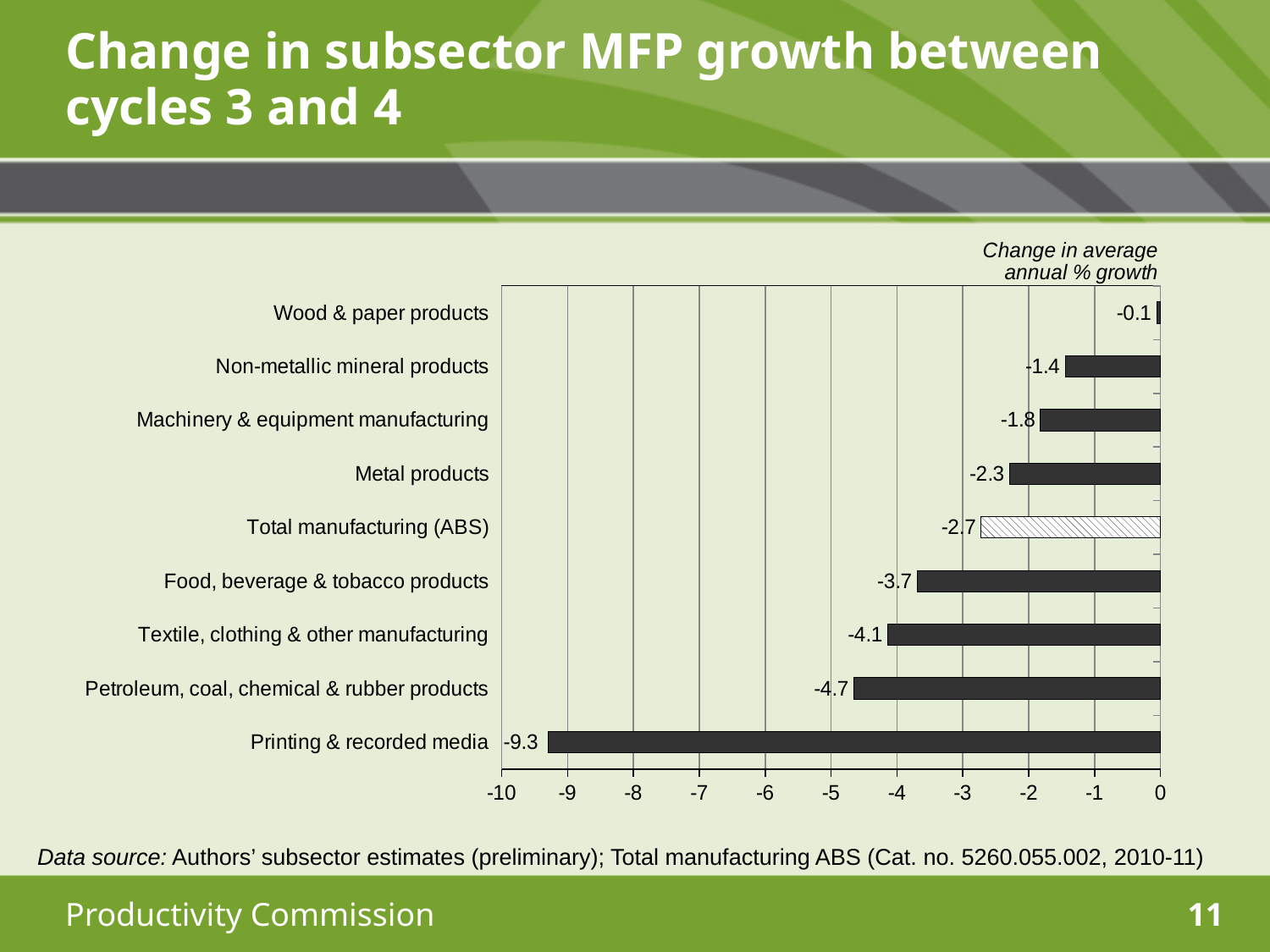
What is the value for Metal products? -2.3 What is the difference between the values for Food, beverage & tobacco products and Textile, clothing & other manufacturing? 0.4 Which is larger, the value for Non-metallic mineral products or the value for Machinery & equipment manufacturing? Non-metallic mineral products What is the value for Petroleum, coal, chemical & rubber products? -4.7 Is the value for Petroleum, coal, chemical & rubber products greater or less than -5? greater How many categories are shown on the chart? 9 Which category has the lowest value? Printing & recorded media Which bar is drawn with a hatched pattern rather than solid fill? Total manufacturing (ABS) Which category has the highest value? Wood & paper products What kind of chart is shown on the slide? bar chart What is the value for Total manufacturing (ABS)? -2.7 What is the value for Printing & recorded media? -9.3